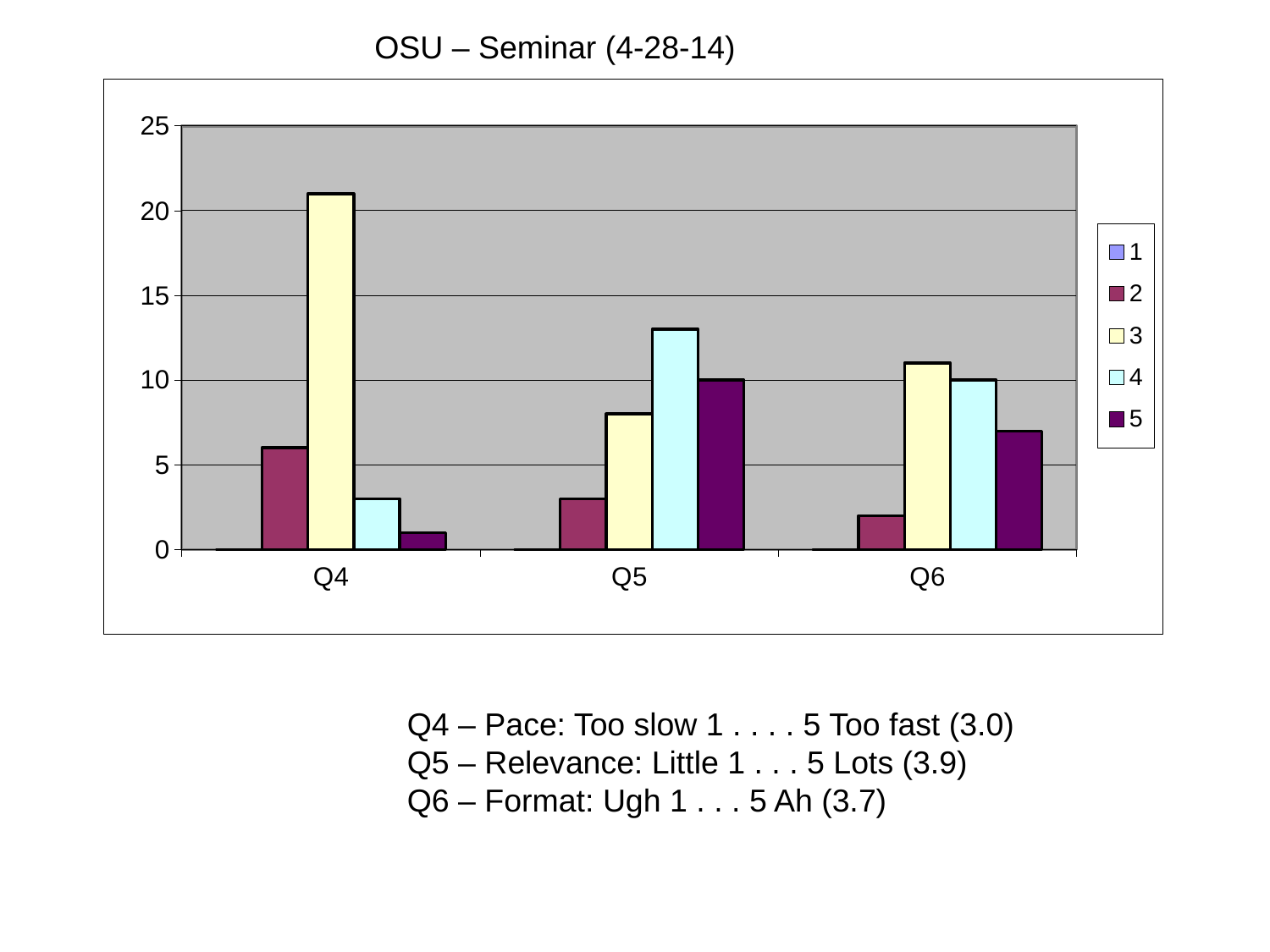
What is the value for series 5 at Q5? 10 Which series has the tallest bar for Q5? 4 Is the value for series 5 at Q6 greater or less than 10? less Is the value for series 4 at Q5 greater or less than 10? greater Is the value for series 3 at Q4 greater or less than 20? greater How many series does the legend list? 5 Which series has the tallest bar for Q4? 3 What is the title of the chart? OSU – Seminar (4-28-14) What kind of chart is shown on the slide? bar chart How many categories are shown on the x axis? 3 Which is larger: the series 3 bar for Q4 or the series 4 bar for Q5? series 3 bar for Q4